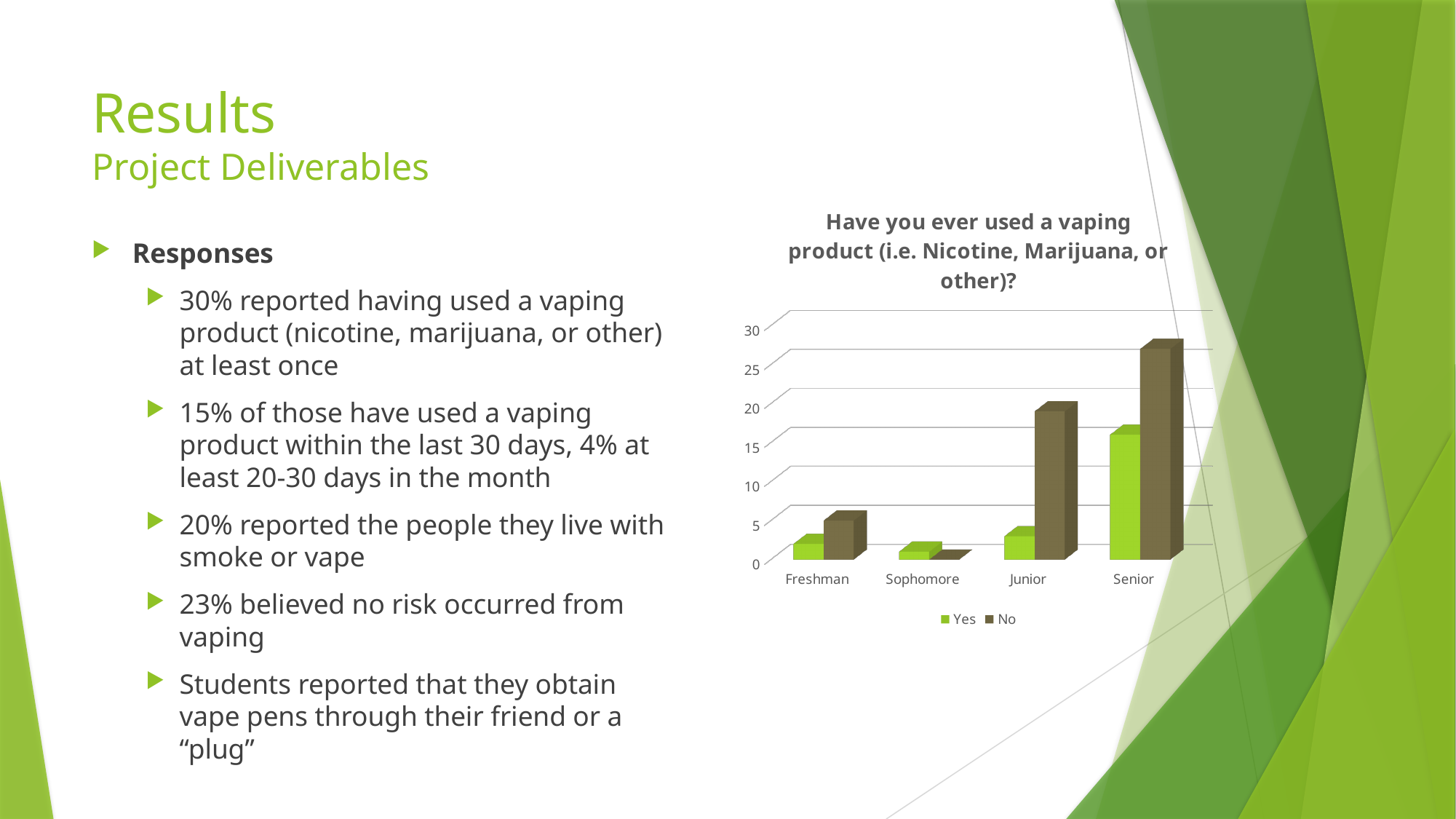
Which category has the lowest 'No' value? Sophomore How many series does the chart's legend list? 2 What is the title of the chart? Have you ever used a vaping product (i.e. Nicotine, Marijuana, or other)? Is the 'No' value for Junior greater or less than 15? greater Is the 'Yes' value for Freshman greater or less than 5? less What kind of chart is shown on the slide? bar chart Which category has the highest 'Yes' value? Senior Which is larger, the 'Yes' value for Senior or the 'Yes' value for Junior? Senior Which category has the highest 'No' value? Senior Is the 'Yes' value for Senior greater or less than 10? greater How many categories are shown on the x axis of the chart? 4